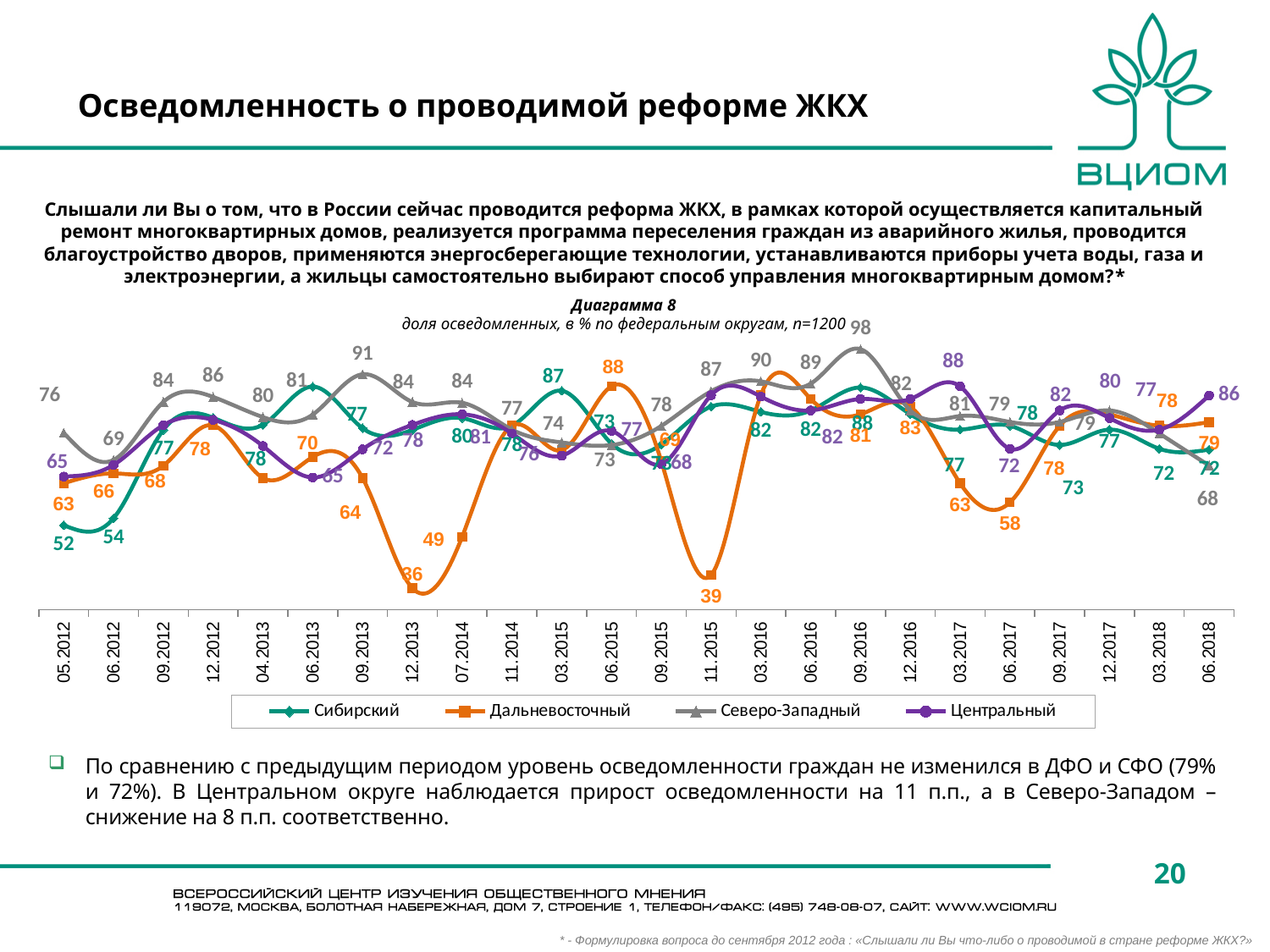
What is the value for Дальневосточный in 11.2015? 39 What is the value for Северо-Западный in 09.2016? 98 What is the difference between the Центральный value (86) and the Северо-Западный value (68) in 06.2018? 18 What is the value for Сибирский in 05.2012? 52 How many time points are shown on the x axis of Диаграмма 8? 24 In which period does the Дальневосточный series reach its lowest value? 12.2013 In 06.2018, which is larger: the value for Центральный or for Северо-Западный? Центральный What kind of chart is Диаграмма 8? line chart What is the value for Дальневосточный in 12.2013? 36 What is the value for Центральный in 06.2018? 86 How many series does the legend of Диаграмма 8 list? 4 In which period does the Северо-Западный series reach its highest value? 09.2016